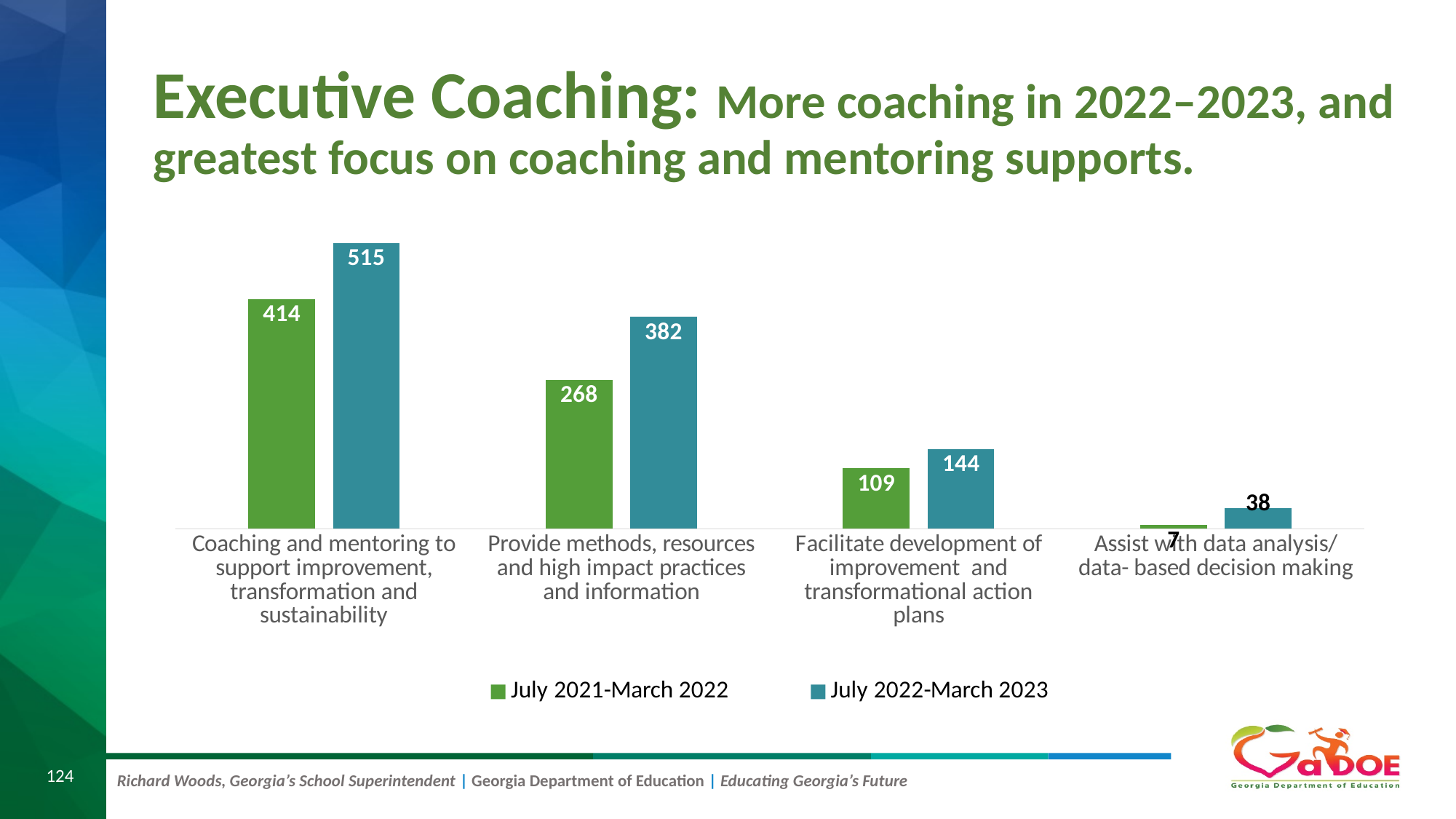
Which is larger: the July 2021-March 2022 value for 'Coaching and mentoring to support improvement, transformation and sustainability' or the July 2022-March 2023 value for 'Provide methods, resources and high impact practices and information'? July 2021-March 2022 value for Coaching and mentoring (414) How many categories are shown on the x axis? 4 What kind of chart is shown on the slide? Bar chart Which category has the highest value in the July 2021-March 2022 series? Coaching and mentoring to support improvement, transformation and sustainability What is the value for 'Coaching and mentoring to support improvement, transformation and sustainability' in the July 2022-March 2023 series? 515 What is the value for 'Assist with data analysis/ data- based decision making' in the July 2022-March 2023 series? 38 How many series does the legend list? 2 Which series is shown in green in the legend? July 2021-March 2022 Which category has the lowest value in the July 2022-March 2023 series? Assist with data analysis/ data- based decision making What is the difference between the July 2022-March 2023 and July 2021-March 2022 values for 'Provide methods, resources and high impact practices and information'? 114 What is the difference between the July 2022-March 2023 and July 2021-March 2022 values for 'Facilitate development of improvement and transformational action plans'? 35 What is the value for 'Provide methods, resources and high impact practices and information' in the July 2021-March 2022 series? 268